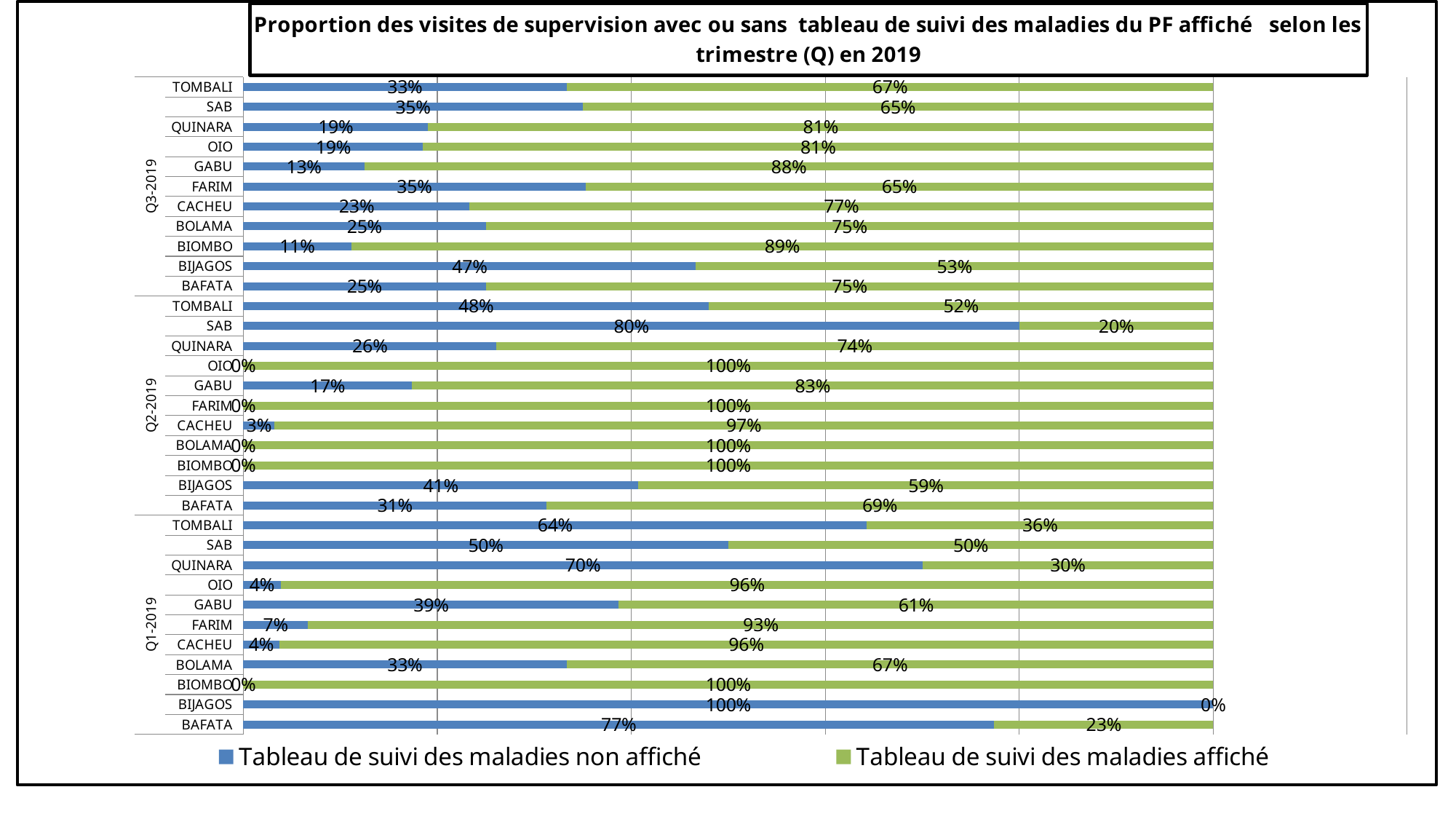
What is the value of "Tableau de suivi des maladies non affiché" for SAB in Q2-2019? 80% What is the difference between the "Tableau de suivi des maladies affiché" values for QUINARA in Q3-2019 and Q1-2019? 51% Which colour represents "Tableau de suivi des maladies affiché" in the chart? Green How many series does the legend list? 2 What kind of chart is shown on the slide? Stacked bar chart Within Q3-2019, which region has the lowest value for "Tableau de suivi des maladies non affiché"? BIOMBO What is the total of the stacked bar for CACHEU in Q2-2019? 100% What is the value of "Tableau de suivi des maladies affiché" for GABU in Q3-2019? 88% What is the value of "Tableau de suivi des maladies non affiché" for BAFATA in Q1-2019? 77% Which is larger: the "Tableau de suivi des maladies non affiché" value for TOMBALI in Q1-2019 or in Q2-2019? Q1-2019 How many bars (region-quarter rows) are plotted in the chart? 33 Within Q3-2019, which region has the highest value for "Tableau de suivi des maladies non affiché"? BIJAGOS